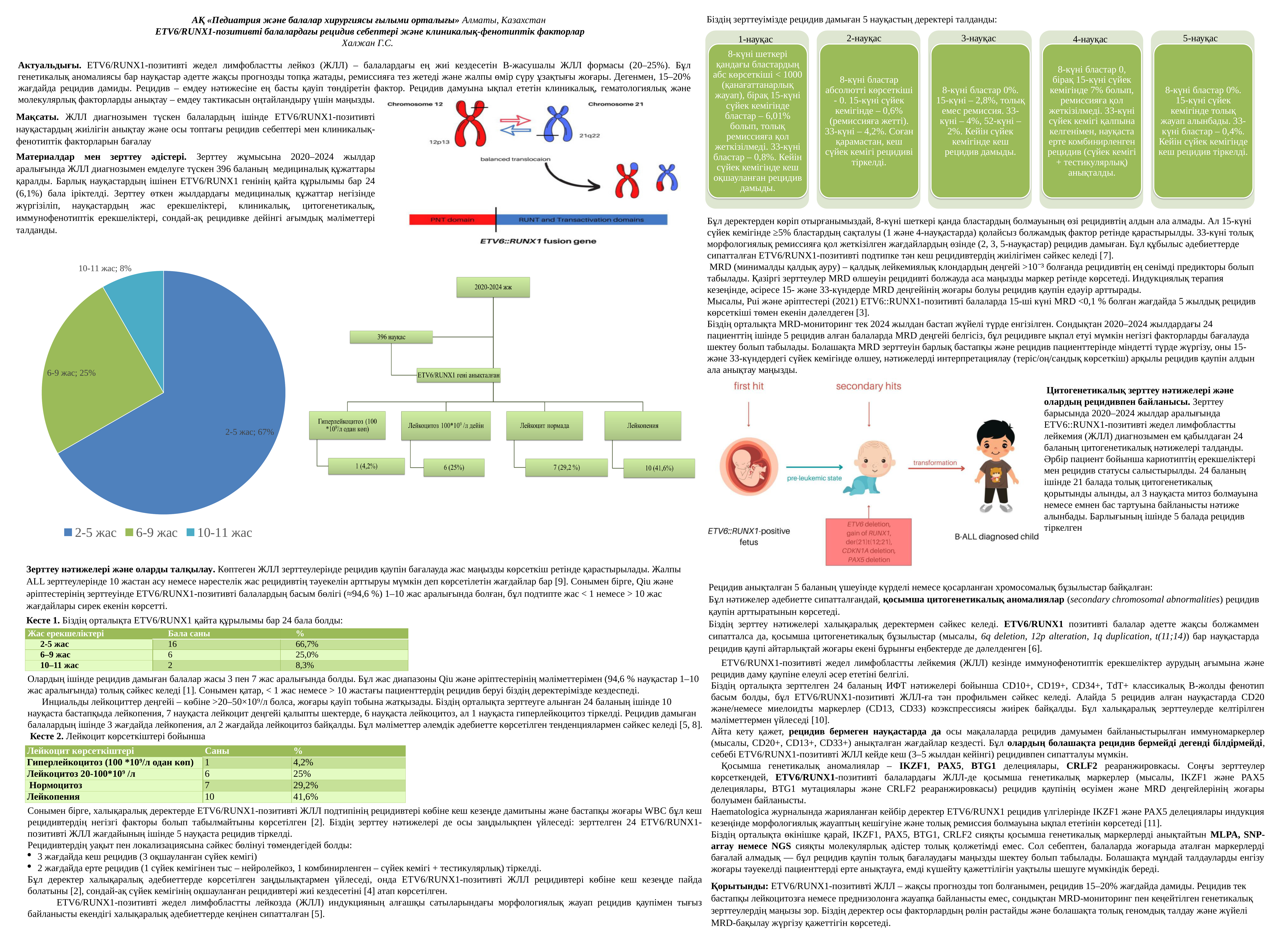
How many slices does the pie chart have? 3 Which age group has the smallest slice in the pie chart? 10-11 жас In the pie chart, what is the combined share of the 6-9 жас and 10-11 жас slices? 33% Which age group has the largest slice in the pie chart? 2-5 жас What colour is the 2-5 жас slice in the pie chart? blue In the pie chart, what share is shown for the 10-11 жас slice? 8% In the pie chart, what is the difference in percentage points between the 2-5 жас slice and the 6-9 жас slice? 42 In the pie chart, what share is shown for the 2-5 жас slice? 67% How many entries does the pie chart legend list? 3 In the pie chart, which slice is larger: 6-9 жас or 10-11 жас? 6-9 жас In the pie chart, what share is shown for the 6-9 жас slice? 25% What kind of chart is shown on the left side of the slide? pie chart